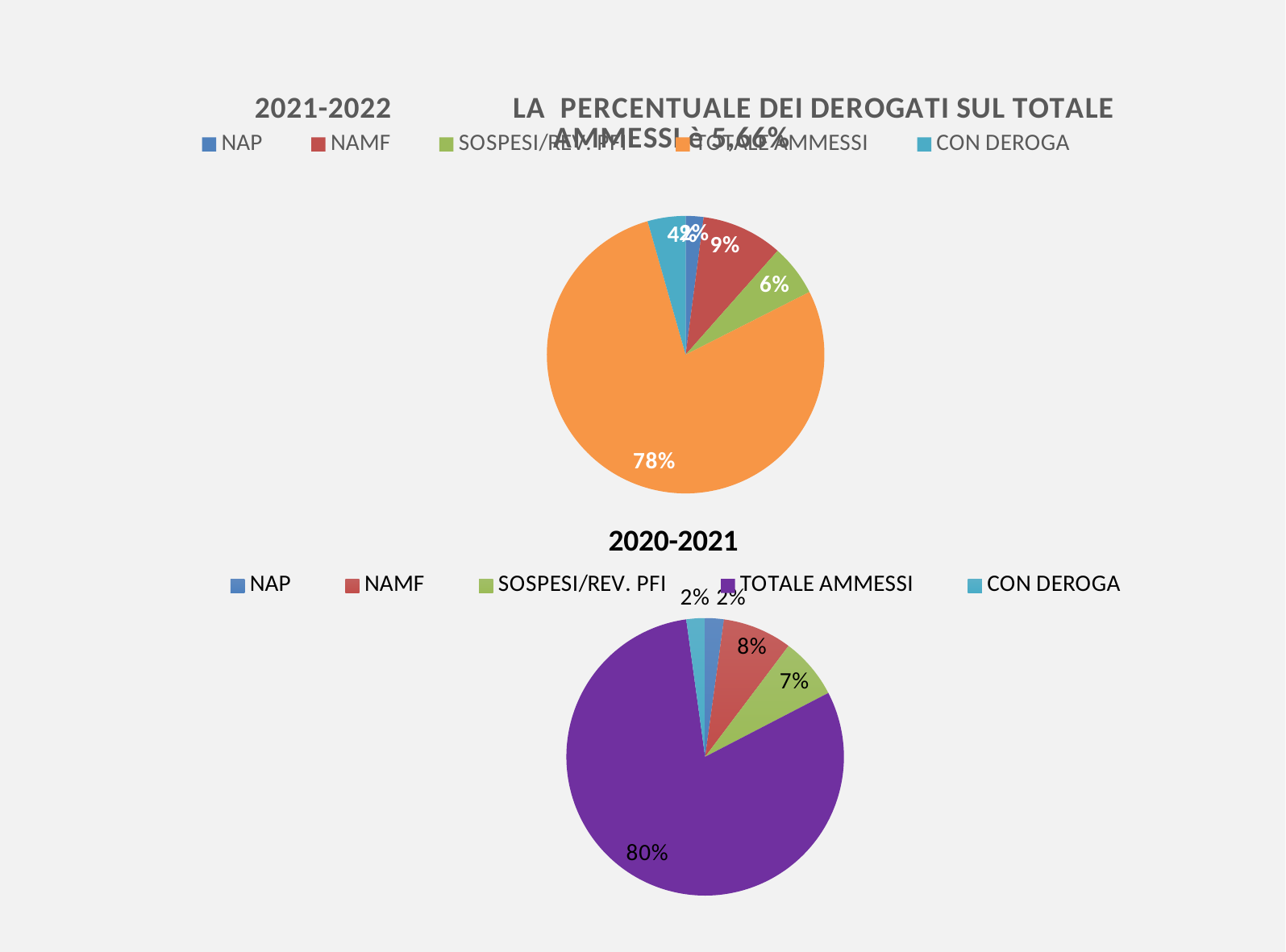
How many entries does the legend of the 2020-2021 chart list? 5 In the 2021-2022 chart, which category has the smallest slice? NAP In the 2021-2022 chart, which is larger, the NAMF slice or the SOSPESI/REV. PFI slice? NAMF In the 2020-2021 chart, which category has the largest slice? TOTALE AMMESSI In the 2020-2021 chart, what percentage is shown for NAMF? 8% In the 2021-2022 chart, what percentage is shown for NAMF? 9% In the 2020-2021 chart, what percentage is shown for TOTALE AMMESSI? 80% In the 2021-2022 chart, what percentage is shown for TOTALE AMMESSI? 78% In the 2020-2021 chart, what is the difference between the NAMF and SOSPESI/REV. PFI percentages? 1% In the 2021-2022 chart, what percentage is shown for SOSPESI/REV. PFI? 6% What type of chart is the 2020-2021 chart? Pie chart In the 2020-2021 chart, what percentage is shown for SOSPESI/REV. PFI? 7%